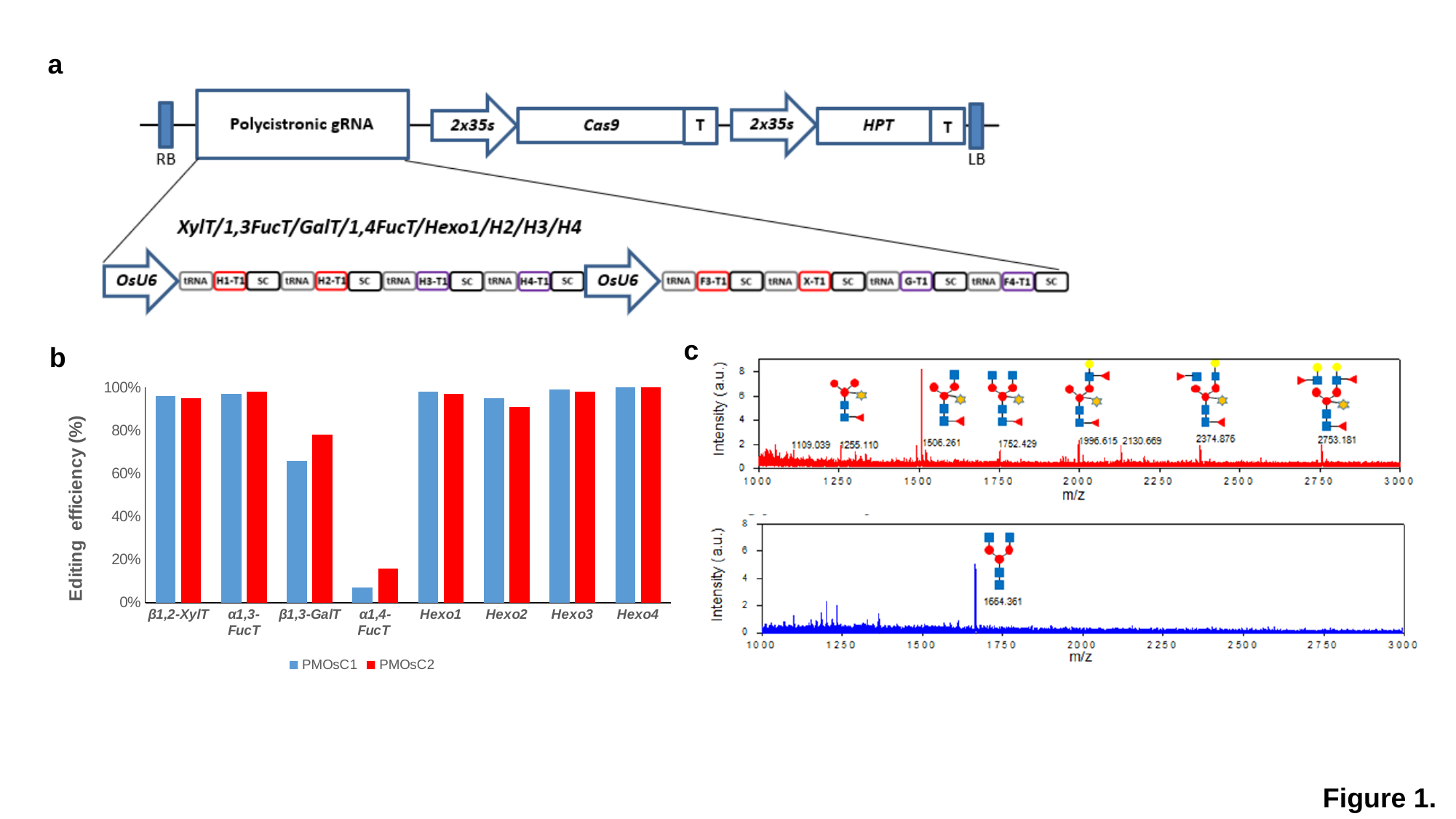
In the bar chart in panel b, is the PMOsC2 editing efficiency for α1,4-FucT greater or less than 20%? less In the bar chart in panel b, for β1,3-GalT, which series has the higher editing efficiency, PMOsC1 or PMOsC2? PMOsC2 In the bar chart in panel b, what kind of chart is it? bar chart In the bar chart in panel b, what colour represents the PMOsC2 series? red In the bar chart in panel b, is the PMOsC1 editing efficiency for Hexo1 greater or less than 80%? greater In the bottom (blue) mass spectrum in panel c, what is the m/z value labelled on the main peak? 1664.361 In the bar chart in panel b, how many target gene categories are shown on the x axis? 8 In the bar chart in panel b, which category has the lowest editing efficiency for PMOsC1? α1,4-FucT In the bar chart in panel b, is the PMOsC1 editing efficiency for β1,3-GalT greater or less than 80%? less In the bar chart in panel b, how many series does the legend list? 2 In the bar chart in panel b, for α1,4-FucT, which series has the higher editing efficiency, PMOsC1 or PMOsC2? PMOsC2 In the bar chart in panel b, which category has the lowest editing efficiency for PMOsC2? α1,4-FucT